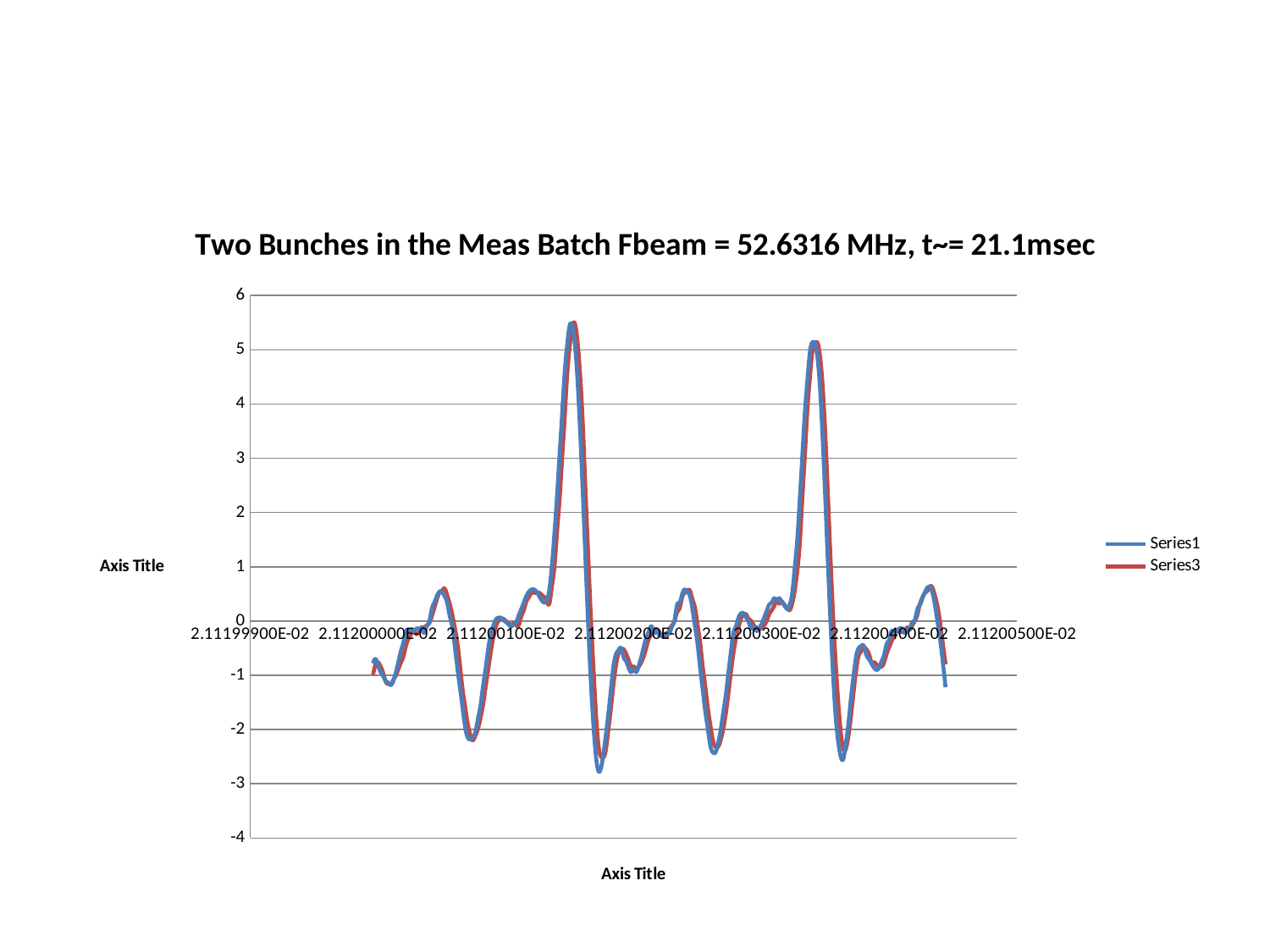
What is the highest value shown on the vertical axis? 6 How many series does the legend list? 2 What is the title of the chart? Two Bunches in the Meas Batch Fbeam = 52.6316 MHz, t~= 21.1msec What kind of chart is shown on the slide? line chart What are the names of the series listed in the legend? Series1 and Series3 Is the lowest value of Series3 greater or less than -3? greater Is the highest peak of Series1 greater or less than 5? greater Is the lowest value of Series1 greater or less than -2? less How many large peaks rise above 4 on the chart? 2 Is the first large peak (near 2.11200200E-02) higher or lower than the second large peak (near 2.11200400E-02)? higher